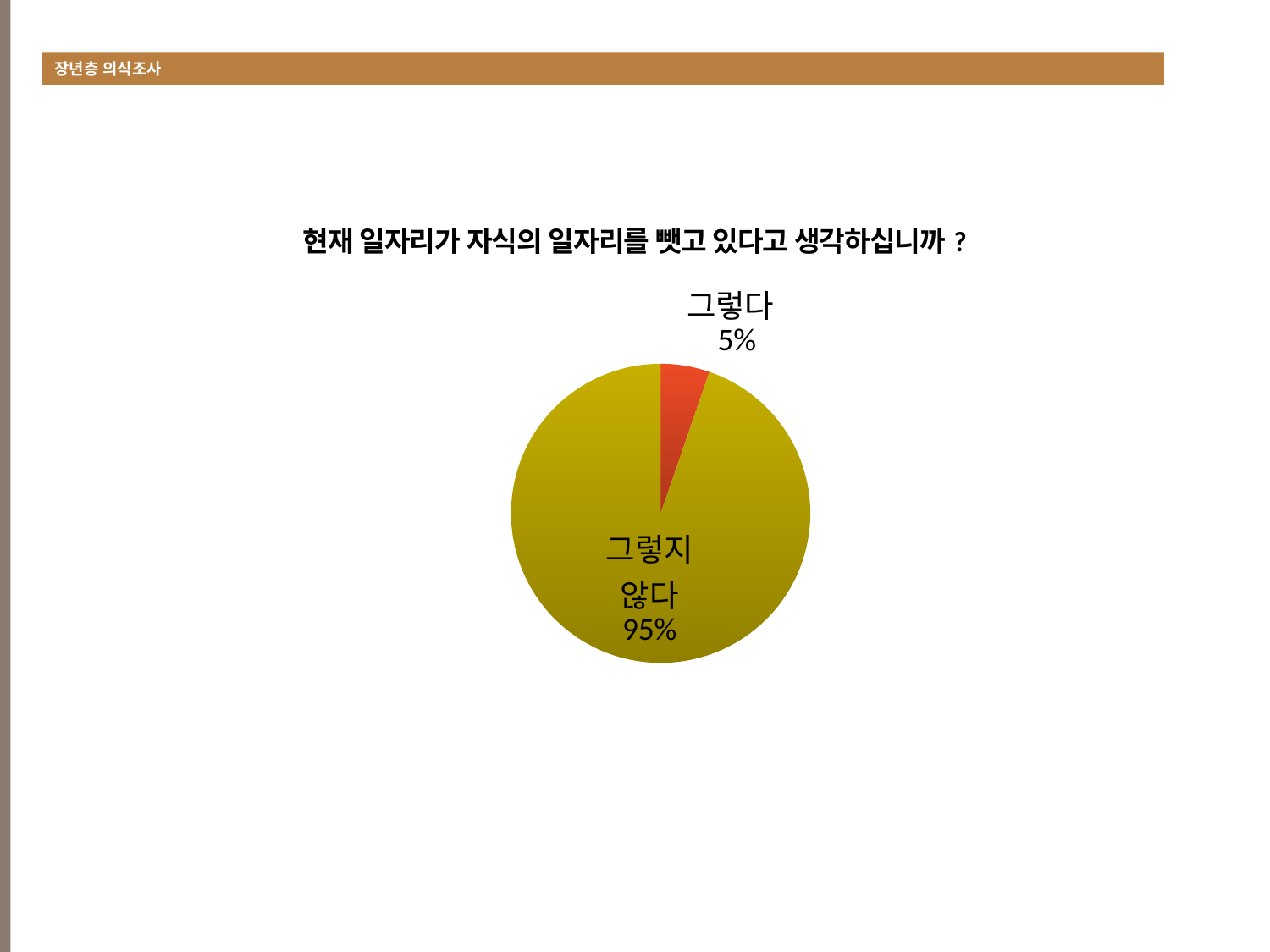
What colour is the slice for 그렇다? orange-red Which response has the largest share of the pie? 그렇지 않다 What kind of chart is shown on the slide? pie chart What is the total of the two slice percentages shown? 100% What is the title of the chart? 현재 일자리가 자식의 일자리를 뺏고 있다고 생각하십니까 ? What percentage of respondents answered 그렇지 않다? 95% What percentage of respondents answered 그렇다? 5% How many slices does the pie chart have? 2 What is the difference in percentage points between 그렇지 않다 and 그렇다? 90 Which response has the smallest share of the pie? 그렇다 Which is larger, the share for 그렇다 or the share for 그렇지 않다? 그렇지 않다